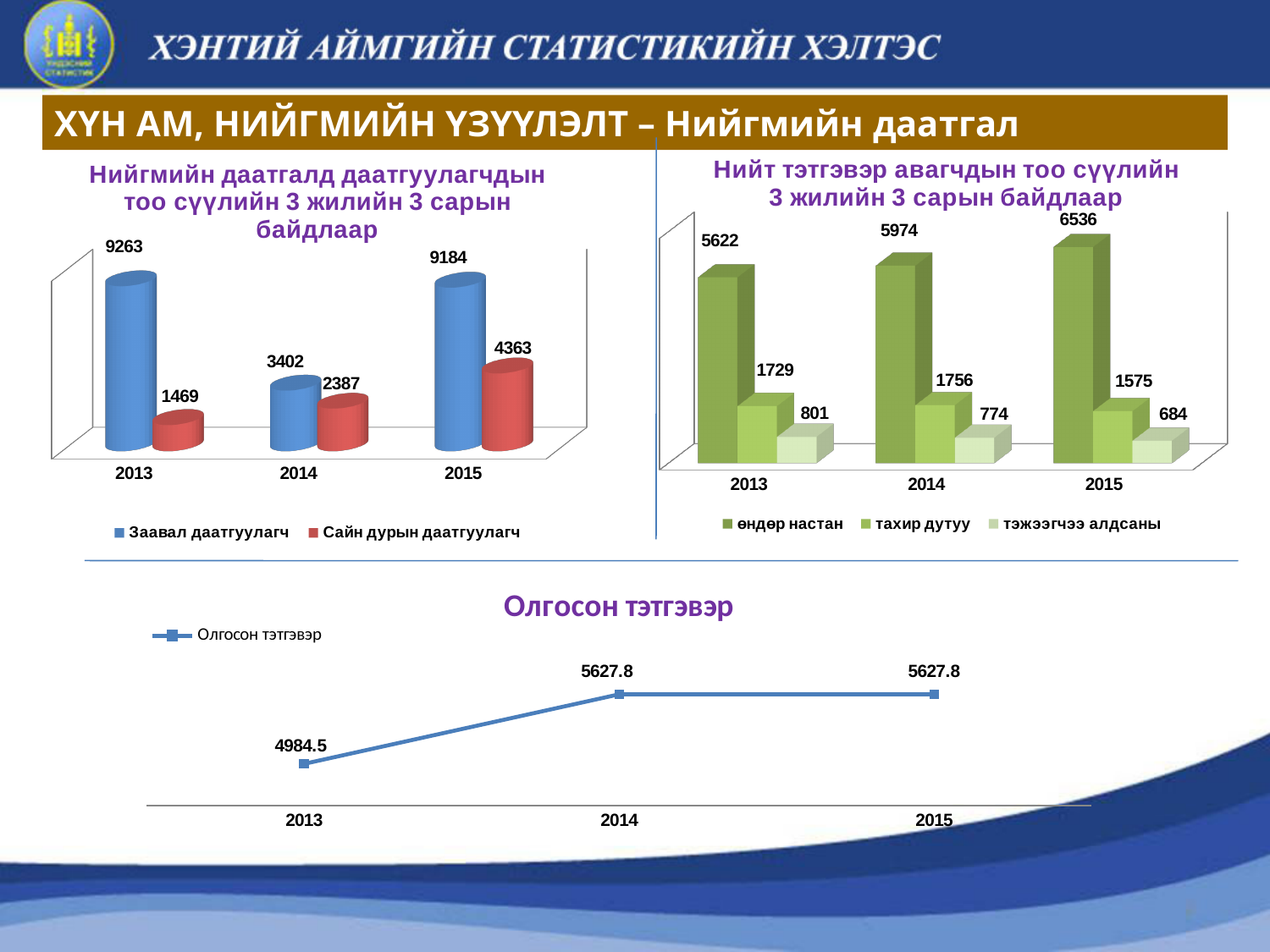
In the top-right chart (Нийт тэтгэвэр авагчдын тоо), what is the value for тэжээгчээ алдсаны in 2014? 774 In the top-right chart (Нийт тэтгэвэр авагчдын тоо), which is larger: тахир дутуу in 2013 or тахир дутуу in 2015? тахир дутуу in 2013 In the top-right chart (Нийт тэтгэвэр авагчдын тоо), what is the value for өндөр настан in 2015? 6536 In the top-left chart (Нийгмийн даатгалд даатгуулагчдын тоо), what is the difference between Заавал даатгуулагч and Сайн дурын даатгуулагч in 2014? 1015 What kind of chart is the bottom chart (Олгосон тэтгэвэр)? line chart In the top-left chart (Нийгмийн даатгалд даатгуулагчдын тоо), how many series does the legend list? 2 In the top-right chart (Нийт тэтгэвэр авагчдын тоо), does the value for өндөр настан rise or fall from 2013 to 2015? rise In the top-right chart (Нийт тэтгэвэр авагчдын тоо), how many series does the legend list? 3 In the top-left chart (Нийгмийн даатгалд даатгуулагчдын тоо), what is the value for Сайн дурын даатгуулагч in 2015? 4363 In the bottom chart (Олгосон тэтгэвэр), what is the value for 2013? 4984.5 In the top-left chart (Нийгмийн даатгалд даатгуулагчдын тоо), what is the value for Заавал даатгуулагч in 2013? 9263 In the top-left chart (Нийгмийн даатгалд даатгуулагчдын тоо), which year has the lowest value for Заавал даатгуулагч? 2014